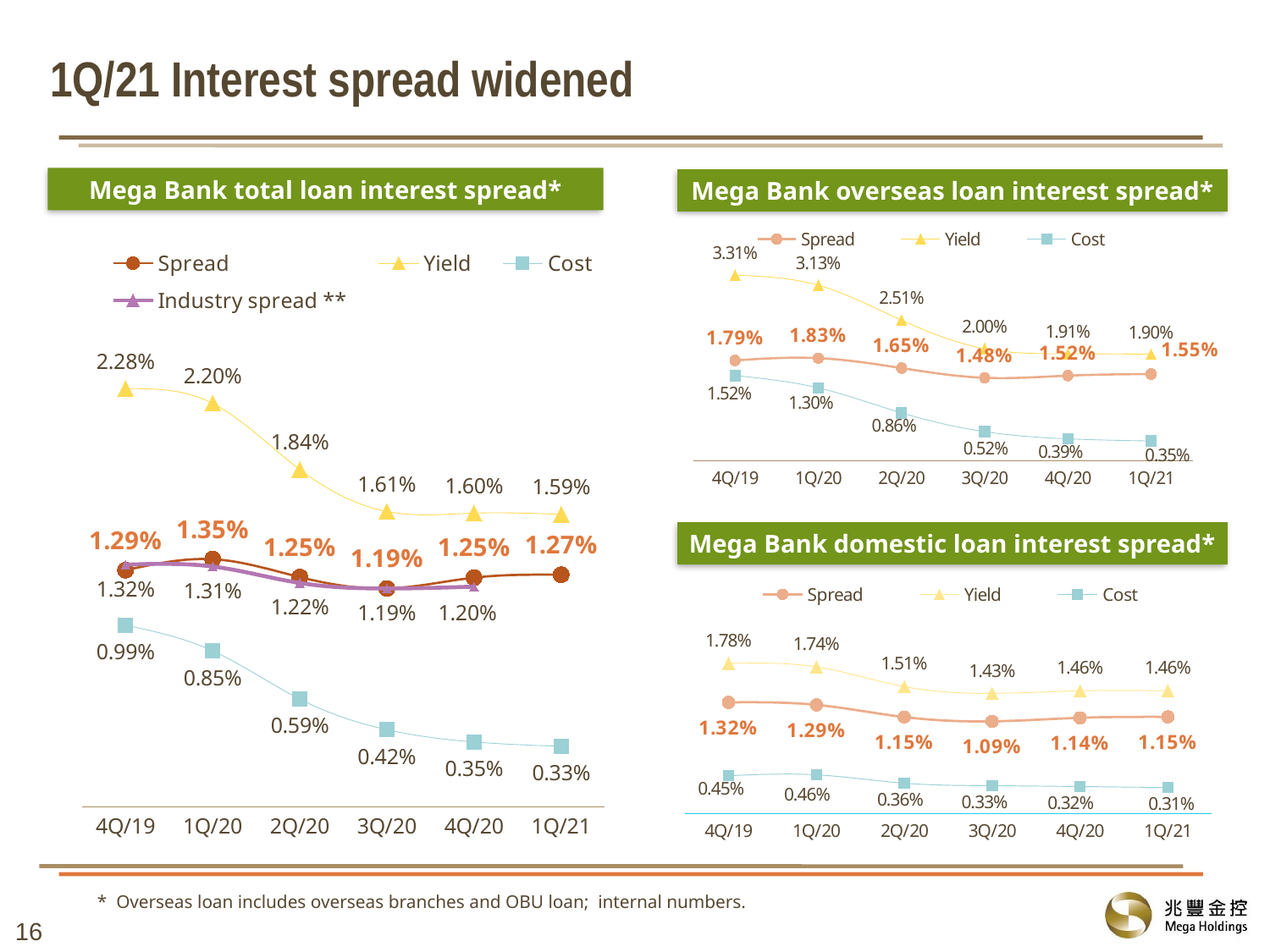
In the 'Mega Bank overseas loan interest spread' chart, does the Cost rise or fall from 4Q/19 to 1Q/21? Fall In the 'Mega Bank domestic loan interest spread' chart, what is the Spread value for 3Q/20? 1.09% In the 'Mega Bank total loan interest spread' chart, what is the Cost value for 4Q/19? 0.99% In the 'Mega Bank total loan interest spread' chart, how many series does the legend list? 4 In the 'Mega Bank total loan interest spread' chart, what is the Spread value for 1Q/21? 1.27% In the 'Mega Bank total loan interest spread' chart, what is the difference between the Yield and the Cost in 1Q/21? 1.26% In the 'Mega Bank domestic loan interest spread' chart, which is larger: the Cost in 4Q/19 or the Cost in 1Q/20? 1Q/20 In the 'Mega Bank overseas loan interest spread' chart, what is the Yield value for 4Q/19? 3.31% How many quarters are shown on the x axis of the 'Mega Bank domestic loan interest spread' chart? 6 In the 'Mega Bank overseas loan interest spread' chart, in which quarter is the Spread lowest? 3Q/20 What type of chart is the 'Mega Bank overseas loan interest spread' chart? Line chart In the 'Mega Bank total loan interest spread' chart, in which quarter is the Spread highest? 1Q/20